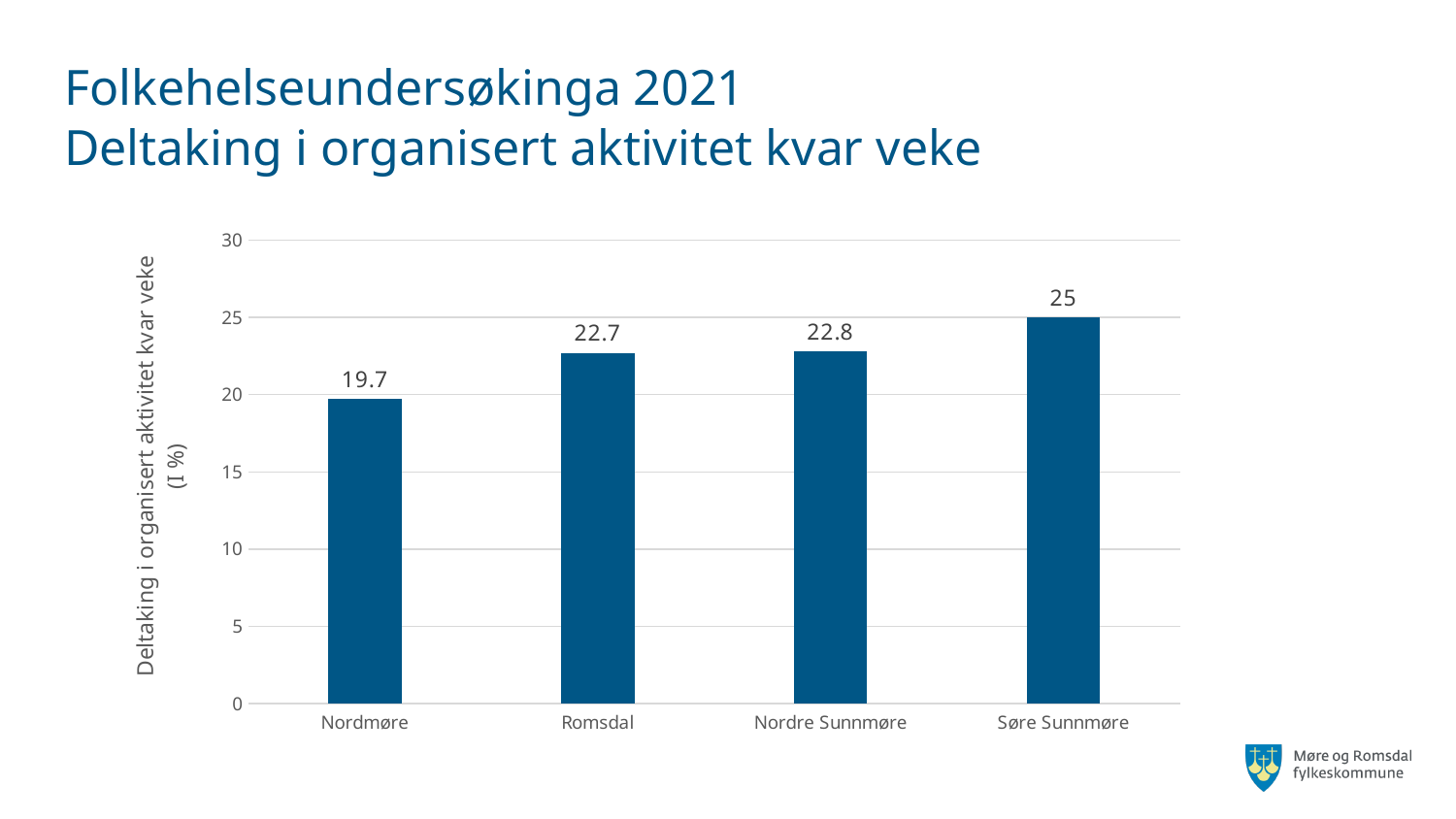
How many regions are shown on the x axis? 4 Which region has the highest value? Søre Sunnmøre What is the value for Nordre Sunnmøre? 22.8 What is the label of the y axis? Deltaking i organisert aktivitet kvar veke (I %) What is the value for Nordmøre? 19.7 What is the difference between the values for Søre Sunnmøre and Nordmøre? 5.3 Which is larger, the value for Søre Sunnmøre or the value for Romsdal? Søre Sunnmøre Which region has the lowest value? Nordmøre What kind of chart is shown on the slide? Bar chart What is the value for Romsdal? 22.7 What is the difference between the values for Romsdal and Nordmøre? 3 What is the value for Søre Sunnmøre? 25